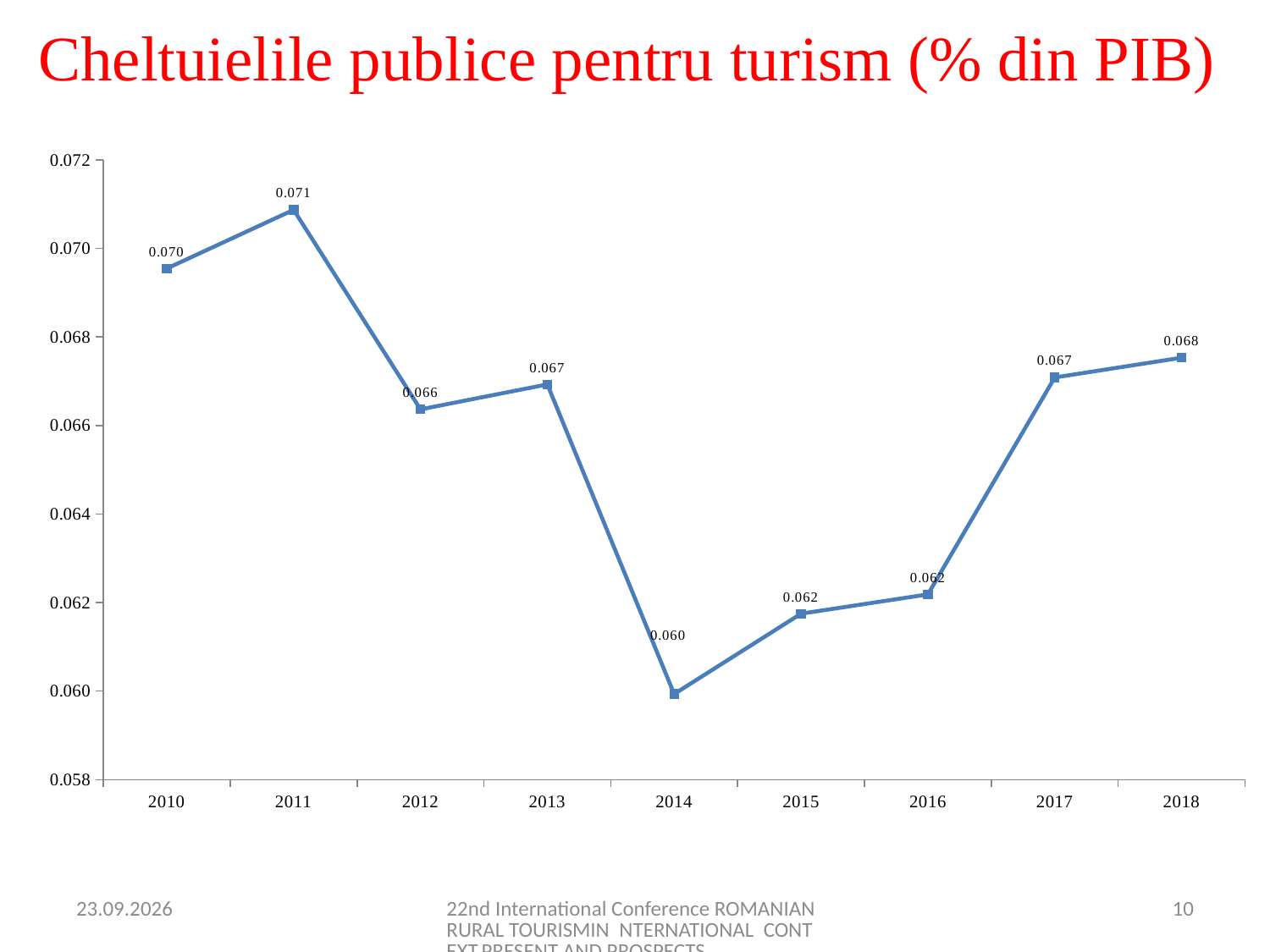
What is the value for 2018? 0.068 What kind of chart is shown on the slide? line chart How many years are plotted on the chart? 9 Do the values rise or fall from 2014 to 2018? rise Which year has the lowest value? 2014 What is the value for 2012? 0.066 What is the value for 2011? 0.071 What is the difference between the values for 2011 and 2014? 0.011 Is the value for 2014 greater or less than 0.062? less Which is larger, the value for 2012 or the value for 2013? 2013 What is the value for 2014? 0.060 Which year has the highest value? 2011